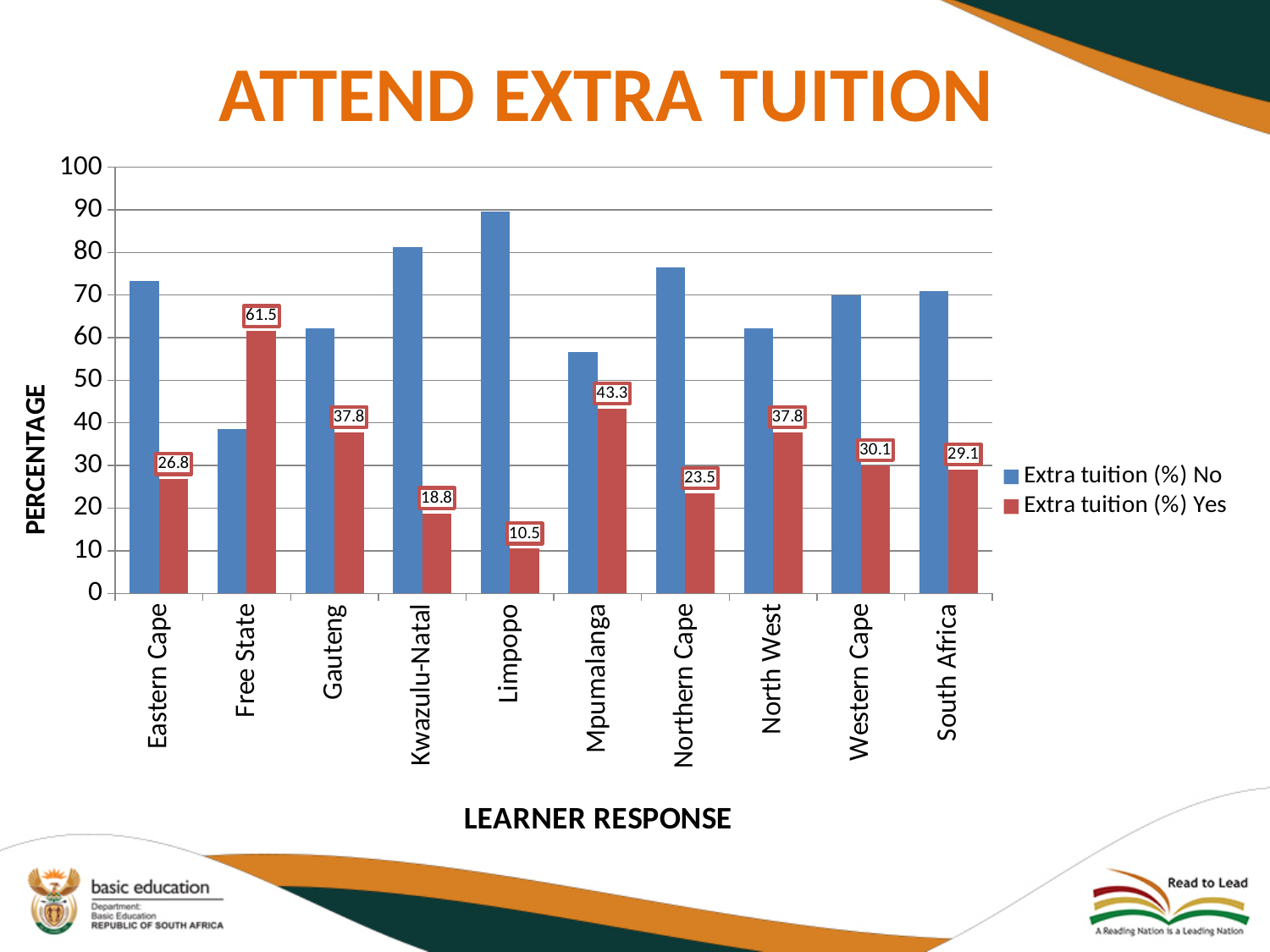
Which province has the lowest value for Extra tuition (%) Yes? Limpopo Is the value for Extra tuition (%) No in Limpopo greater or less than 80? greater What is the value for Extra tuition (%) Yes in Limpopo? 10.5 What is the value for Extra tuition (%) Yes in Free State? 61.5 Which is larger: the Extra tuition (%) Yes value for Western Cape or for Northern Cape? Western Cape What is the difference between the Extra tuition (%) Yes values for Free State and Limpopo? 51.0 Which province has the highest value for Extra tuition (%) Yes? Free State Is the value for Extra tuition (%) No in Free State greater or less than 40? less How many series does the legend list? 2 What kind of chart is shown on the slide? Bar chart What is the value for Extra tuition (%) Yes in Mpumalanga? 43.3 How many categories are shown on the x axis? 10